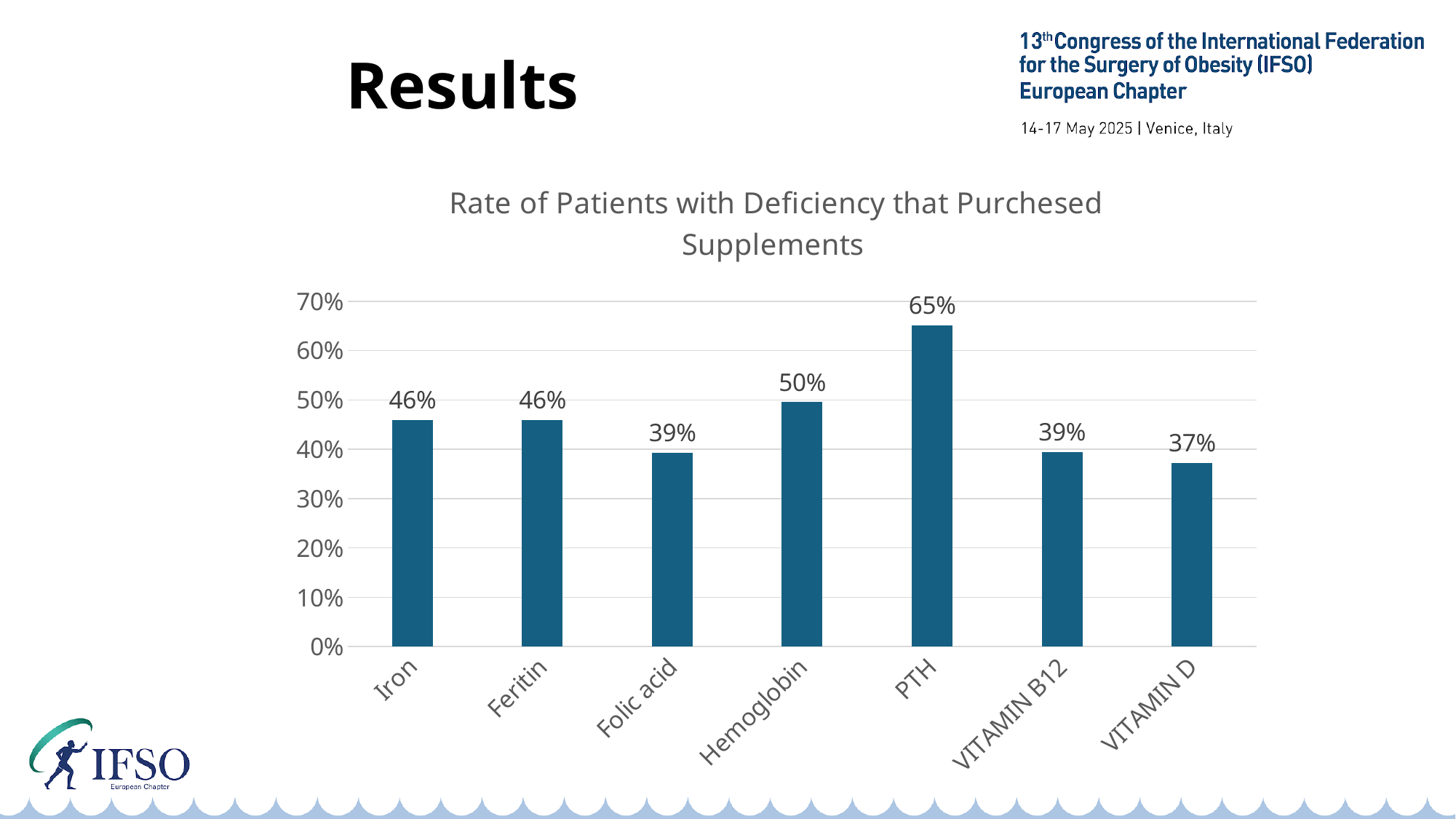
What is the title of the chart? Rate of Patients with Deficiency that Purchesed Supplements What is the difference between the values for PTH and Hemoglobin? 15% Which category has the highest value? PTH How many categories are shown on the x axis? 7 What is the value for Folic acid? 39% What is the value for PTH? 65% What kind of chart is shown on the slide? Bar chart Which category has the lowest value? VITAMIN D What is the difference between the values for Iron and VITAMIN D? 9% Which is larger, the value for Hemoglobin or the value for VITAMIN B12? Hemoglobin What is the value for Hemoglobin? 50% What is the value for VITAMIN D? 37%